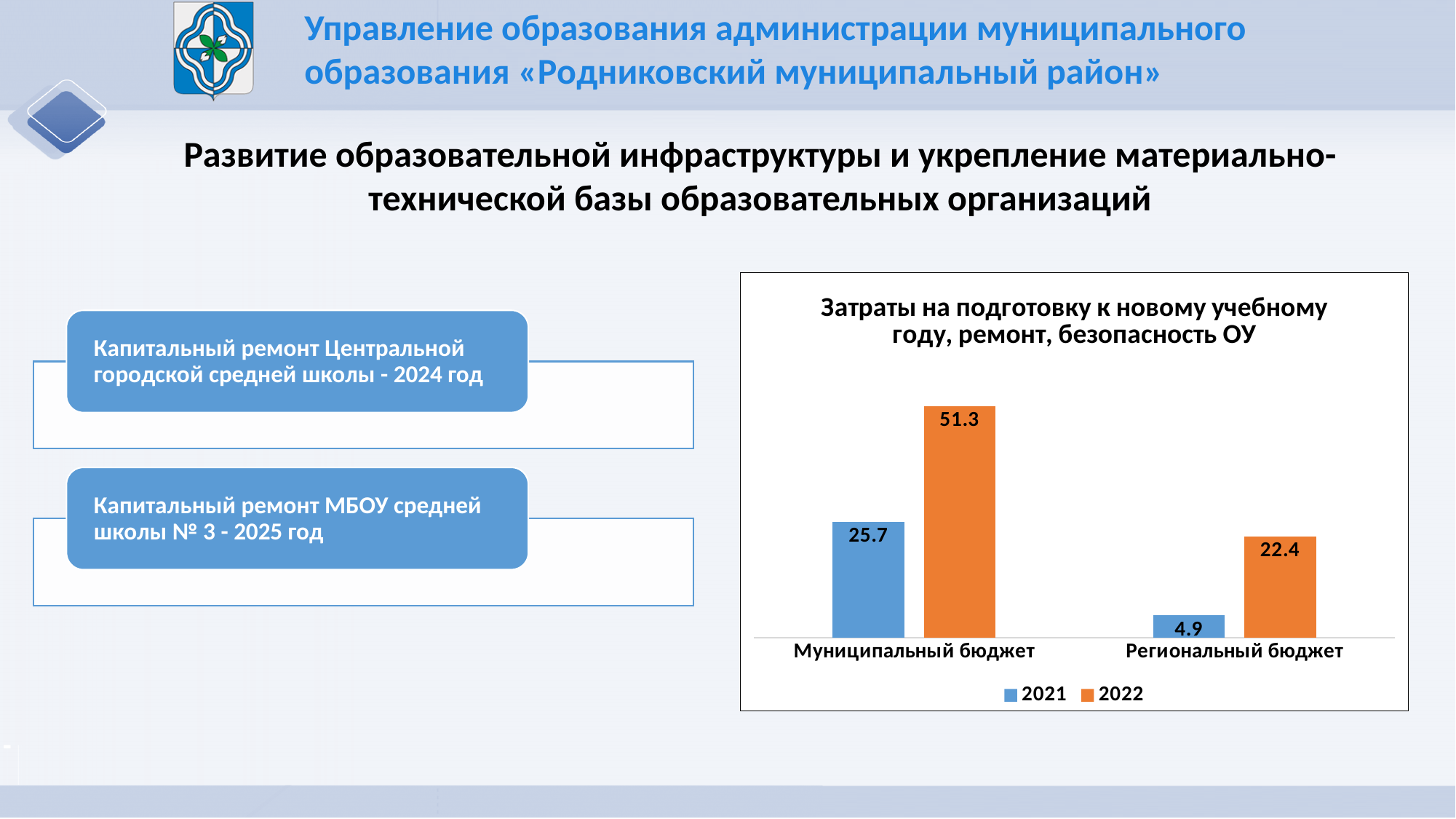
What is the value for Региональный бюджет in 2021? 4.9 How many categories are shown on the x axis? 2 What is the difference between the 2022 and 2021 values for Региональный бюджет? 17.5 What kind of chart is shown on the slide? Bar chart What is the value for Региональный бюджет in 2022? 22.4 What is the difference between the 2022 and 2021 values for Муниципальный бюджет? 25.6 Which category has the highest value in the 2022 series? Муниципальный бюджет How many series does the legend list? 2 What is the value for Муниципальный бюджет in 2022? 51.3 What is the value for Муниципальный бюджет in 2021? 25.7 Which category has the lowest value in the 2021 series? Региональный бюджет Which is larger: the 2021 value for Муниципальный бюджет or the 2022 value for Региональный бюджет? 2021 value for Муниципальный бюджет